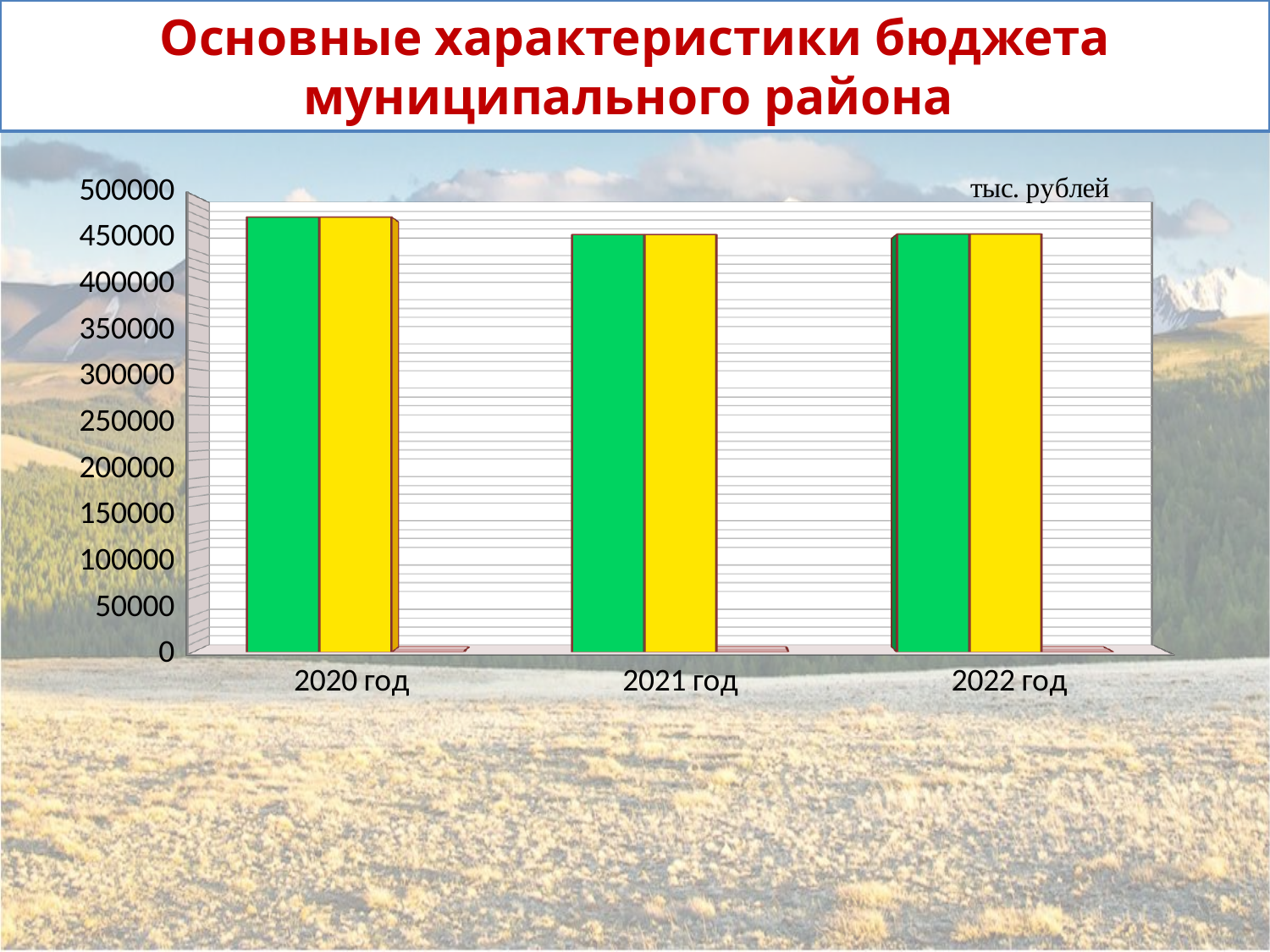
What kind of chart is shown on the slide? bar chart Which year has the highest bars? 2020 год Which is larger, the green bar for 2020 год or the green bar for 2021 год? 2020 год Do the bar values rise or fall from 2020 год to 2021 год? fall Is the green bar for 2020 год greater or less than 450000? greater How many year categories are shown on the x axis? 3 Is the green bar for 2021 год greater or less than 500000? less What unit is indicated in the top right corner of the chart? тыс. рублей Is the yellow bar for 2022 год greater or less than 400000? greater What is the title of the slide? Основные характеристики бюджета муниципального района